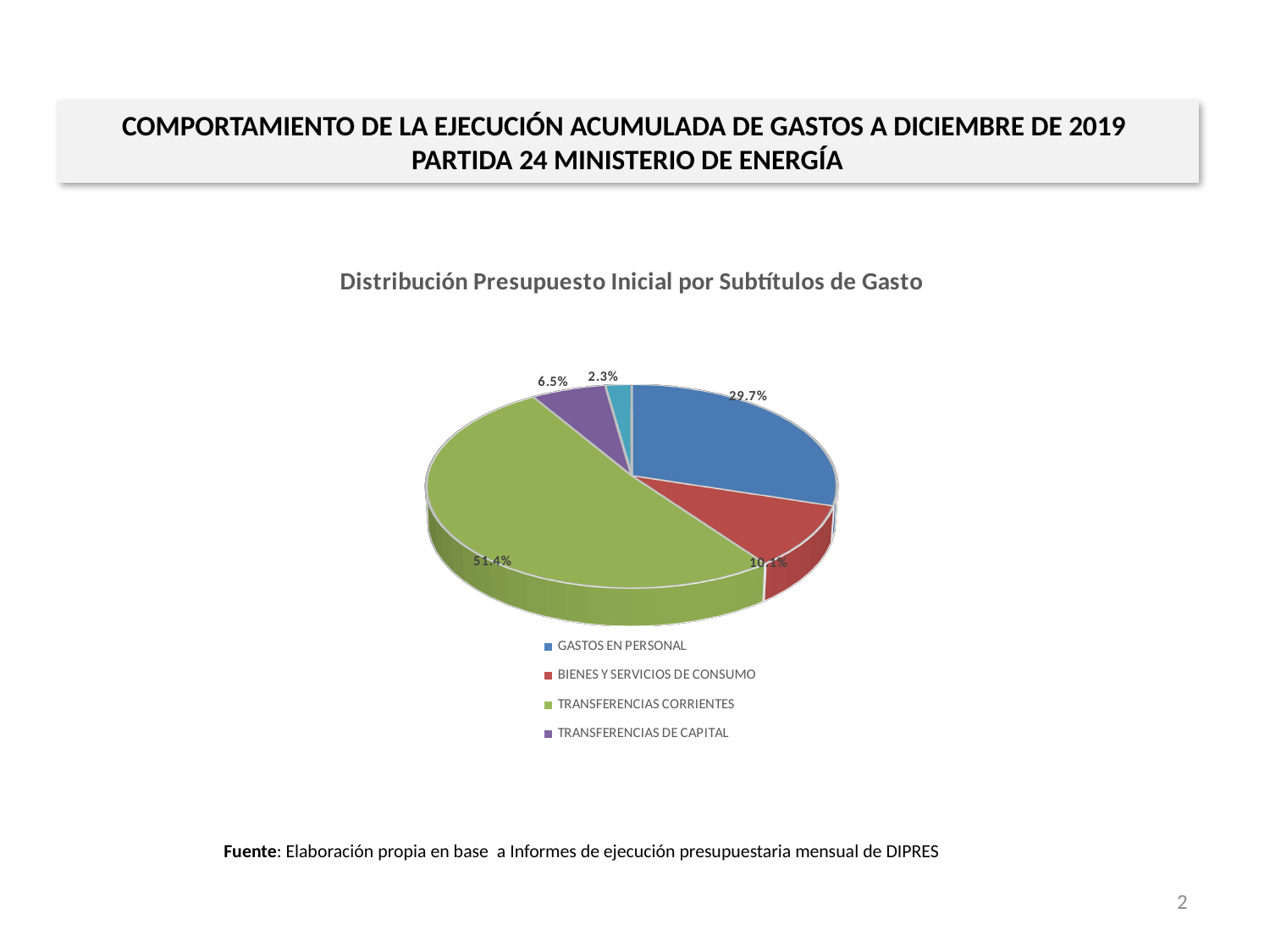
What share of the pie does GASTOS EN PERSONAL represent? 29.7% What share of the pie does BIENES Y SERVICIOS DE CONSUMO represent? 10.1% What share of the pie does TRANSFERENCIAS DE CAPITAL represent? 6.5% What is the smallest percentage shown on the pie chart? 2.3% Which is larger, the share for BIENES Y SERVICIOS DE CONSUMO or the share for TRANSFERENCIAS DE CAPITAL? BIENES Y SERVICIOS DE CONSUMO What is the title of the chart? Distribución Presupuesto Inicial por Subtítulos de Gasto What is the difference in percentage points between TRANSFERENCIAS CORRIENTES and GASTOS EN PERSONAL? 21.7 Which category has the largest share of the pie? TRANSFERENCIAS CORRIENTES What share of the pie does TRANSFERENCIAS CORRIENTES represent? 51.4% How many slices does the pie chart have? 5 What kind of chart is shown on the slide? Pie chart How many entries does the legend list? 4